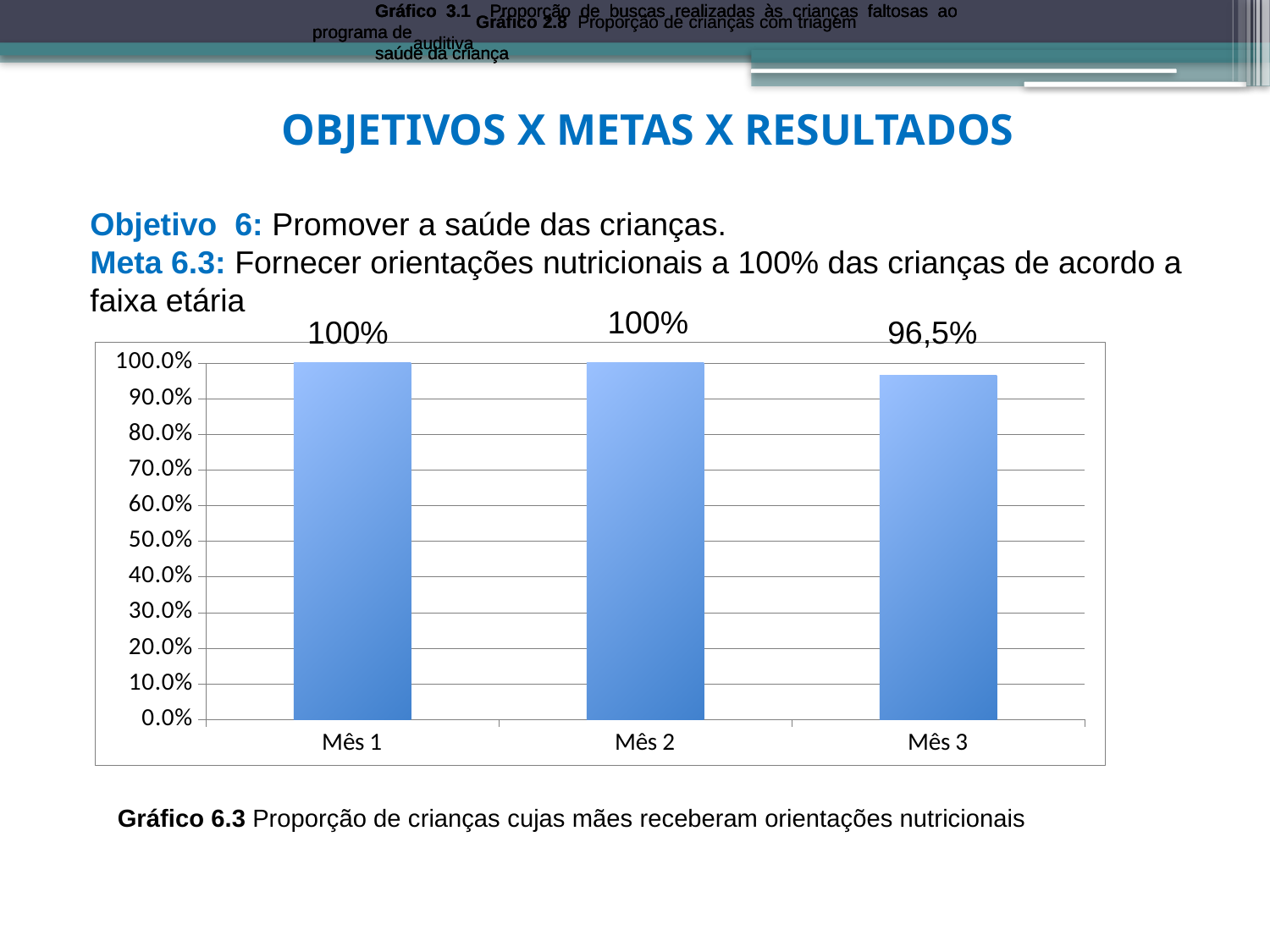
What is the highest value shown on the y axis? 100.0% Is the value for Mês 3 greater or less than 90.0%? greater What is the value for Mês 2? 100% What kind of chart is shown on the slide? bar chart What is the value for Mês 3? 96,5% What is the value for Mês 1? 100% What is the caption of the chart (Gráfico 6.3)? Proporção de crianças cujas mães receberam orientações nutricionais Which is larger, the value for Mês 2 or the value for Mês 3? Mês 2 How many months are shown on the x axis? 3 Do the values rise or fall from Mês 2 to Mês 3? fall Which month has the lowest value? Mês 3 What is the difference between the values for Mês 1 and Mês 3? 3,5%